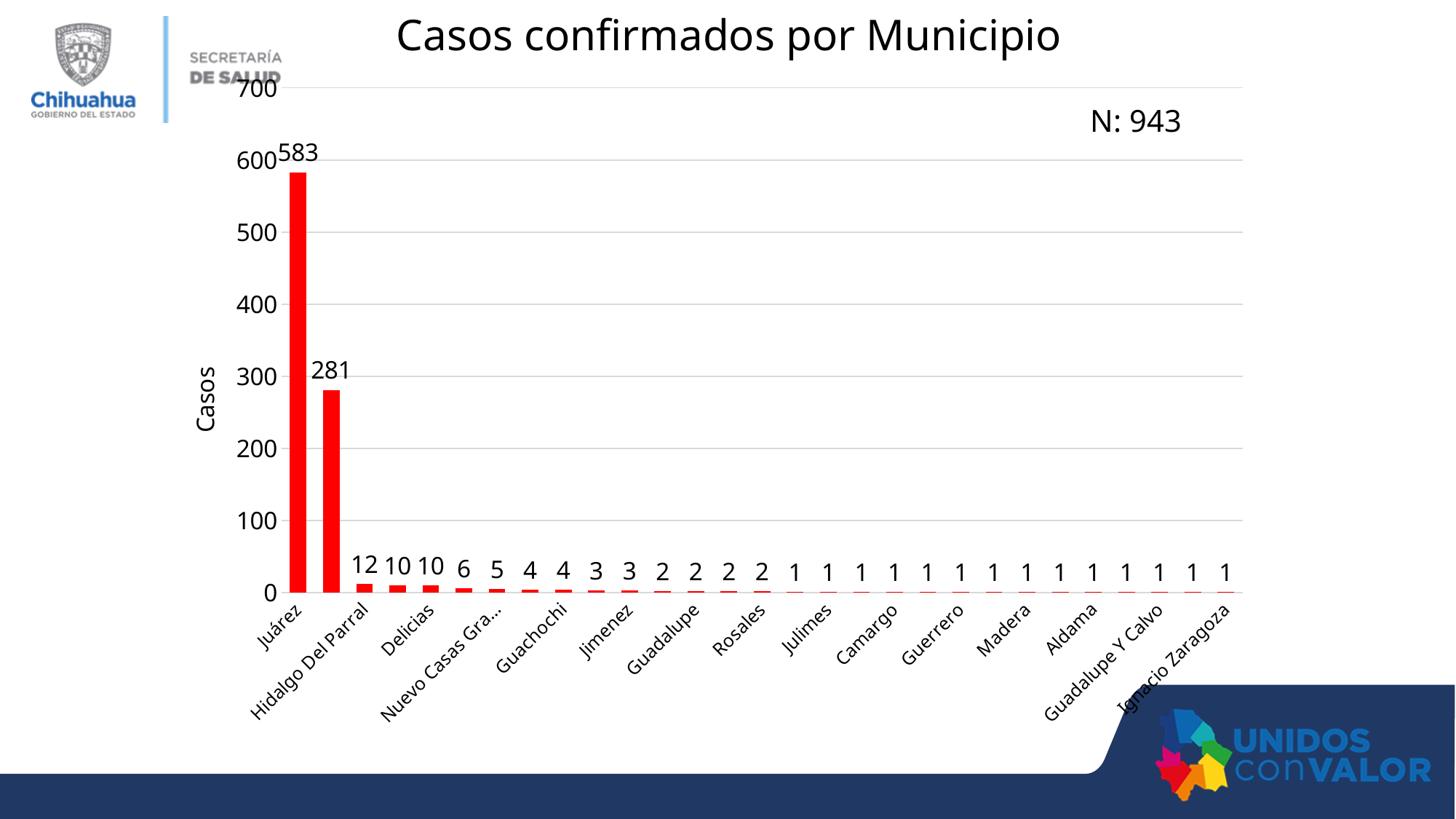
Which has more confirmed cases, Juárez or Delicias? Juárez How many confirmed cases does Camargo have? 1 What is the title of the chart? Casos confirmados por Municipio What is the value shown for Guachochi? 4 What is the difference between the values for Juárez and Delicias? 573 What is the value shown for Jimenez? 3 Do the values rise or fall from left to right along the x axis? Fall How many confirmed cases does Juárez have? 583 Which municipality has the highest number of confirmed cases? Juárez What kind of chart is shown on the slide? Bar chart What is the value shown for Rosales? 2 What is the value shown for Delicias? 10